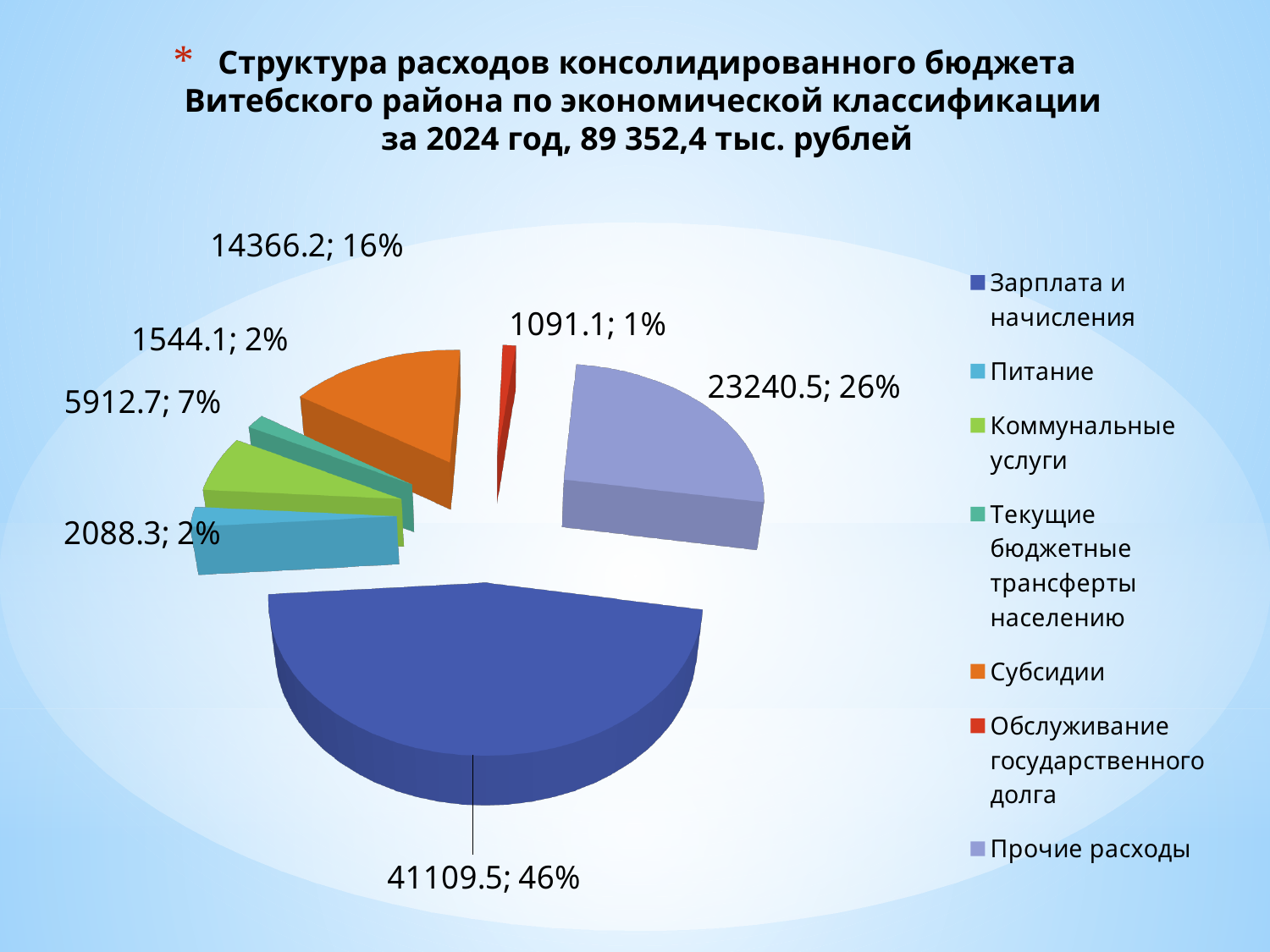
How many categories does the legend of the pie chart list? 7 What share of the pie does Прочие расходы take? 26% What value is shown for Обслуживание государственного долга? 1091.1 Which category has the smallest slice of the pie? Обслуживание государственного долга What value is shown for Зарплата и начисления? 41109.5 What value is shown for Субсидии? 14366.2 What colour is the slice for Субсидии? orange Which is larger, the value for Субсидии or the value for Прочие расходы? Прочие расходы What is the difference between the value for Зарплата и начисления and the value for Прочие расходы? 17869 What kind of chart is shown on the slide? pie chart What share of the pie does Коммунальные услуги take? 7% Which category has the largest slice of the pie? Зарплата и начисления